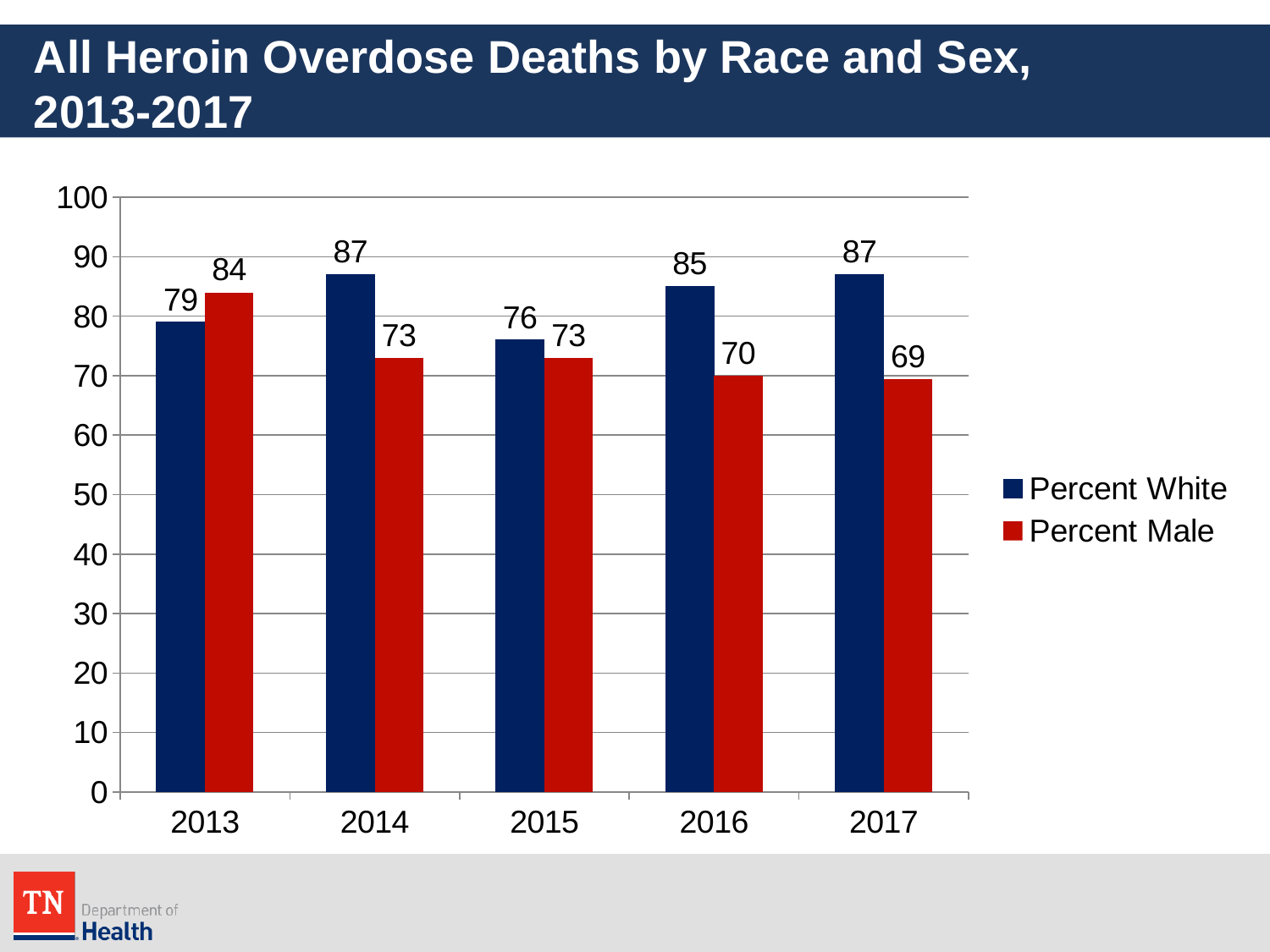
How many years are shown on the x axis? 5 What is the Percent Male value for 2017? 69 Which year has the lowest Percent White value? 2015 What kind of chart is shown on the slide? Bar chart Does the Percent Male value rise or fall from 2013 to 2017? Fall Which is larger in 2013, Percent White or Percent Male? Percent Male Which year has the highest Percent Male value? 2013 What is the difference between Percent White and Percent Male in 2016? 15 What colour are the Percent Male bars? Red What is the Percent White value for 2013? 79 What is the Percent Male value for 2013? 84 How many series does the legend list? 2